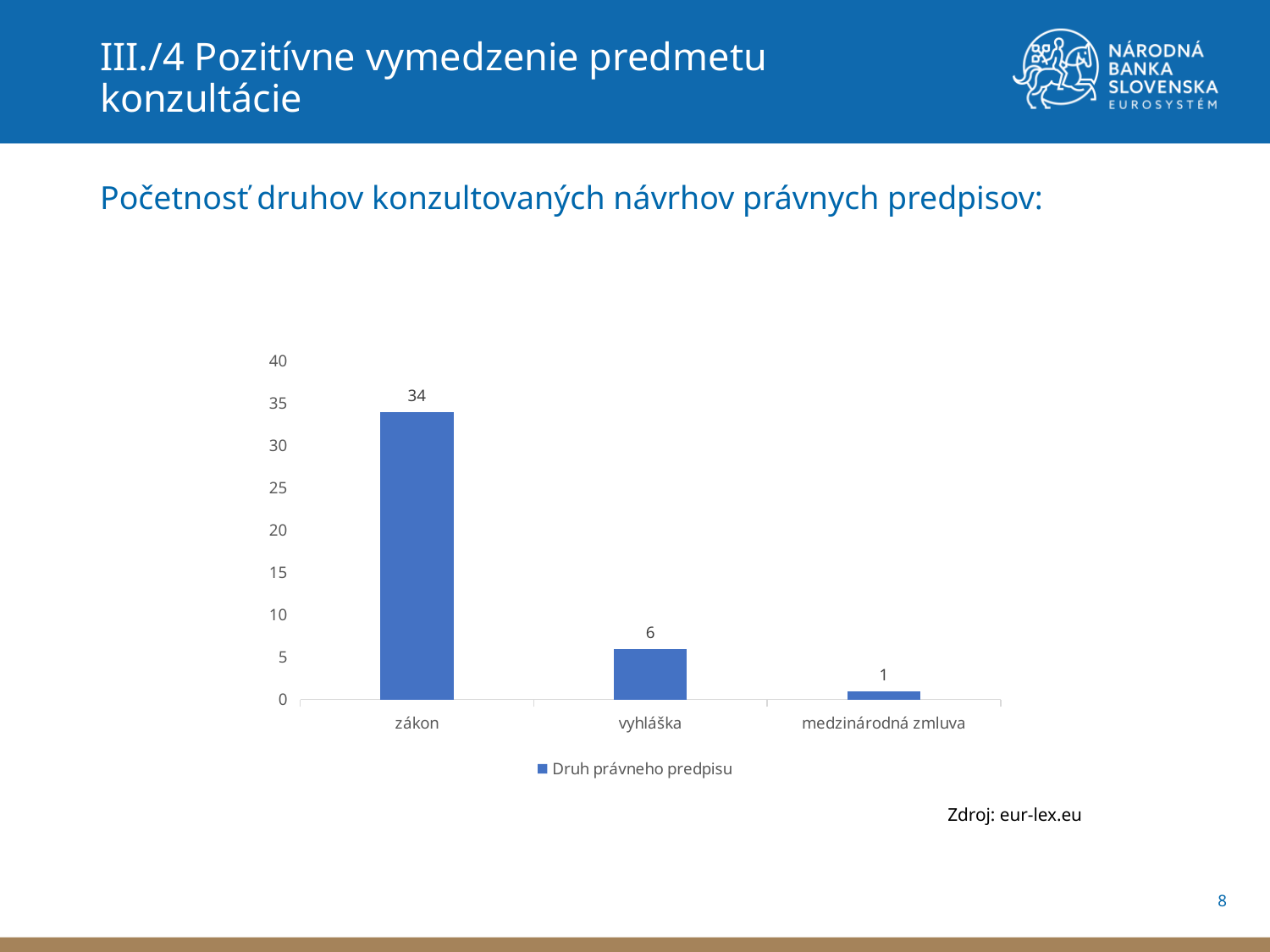
Which category has the lowest value? medzinárodná zmluva What is the value for medzinárodná zmluva? 1 What is the value for zákon? 34 Which category has the highest value? zákon What is the value for vyhláška? 6 How many categories are shown on the x axis? 3 What kind of chart is shown on the slide? bar chart Is the value for zákon greater or less than 30? greater What is the difference between the values for zákon and vyhláška? 28 What series name does the legend show? Druh právneho predpisu Which is larger, the value for vyhláška or the value for medzinárodná zmluva? vyhláška What is the difference between the values for vyhláška and medzinárodná zmluva? 5